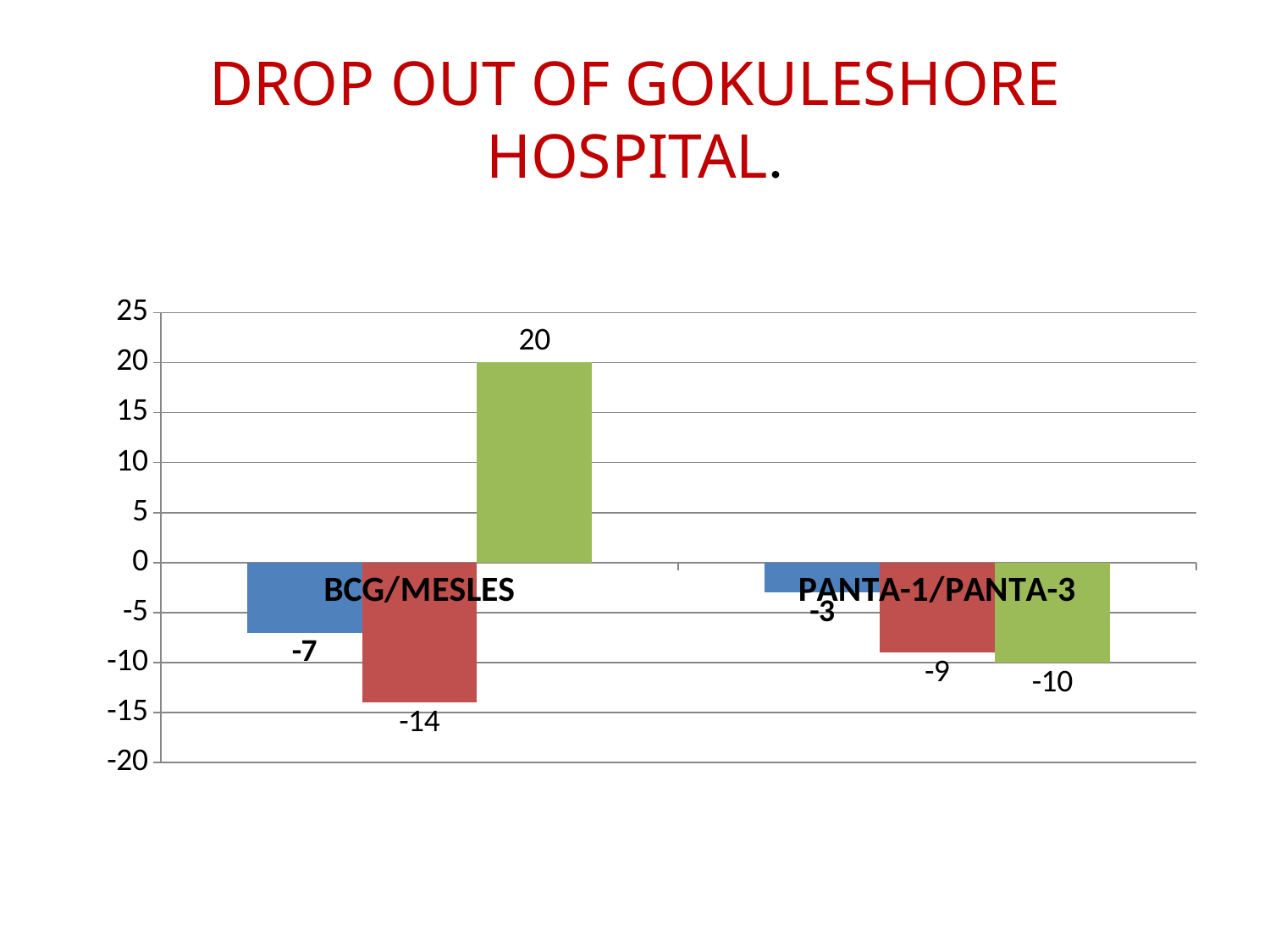
What is the title of the slide containing the chart? DROP OUT OF GOKULESHORE HOSPITAL. Which bar has the highest value in the chart? the green bar for BCG/MESLES (20) What is the value of the red bar for BCG/MESLES? -14 Which bar has the lowest value in the chart? the red bar for BCG/MESLES (-14) What kind of chart is shown on the slide? bar chart What is the value of the green bar for PANTA-1/PANTA-3? -10 What is the value of the blue bar for PANTA-1/PANTA-3? -3 What is the difference between the green bar and the red bar for BCG/MESLES? 34 What is the value of the green bar for BCG/MESLES? 20 What is the difference between the red bar for BCG/MESLES and the red bar for PANTA-1/PANTA-3? 5 How many categories are shown on the x axis of the chart? 2 Which is larger, the blue bar for BCG/MESLES or the blue bar for PANTA-1/PANTA-3? the blue bar for PANTA-1/PANTA-3